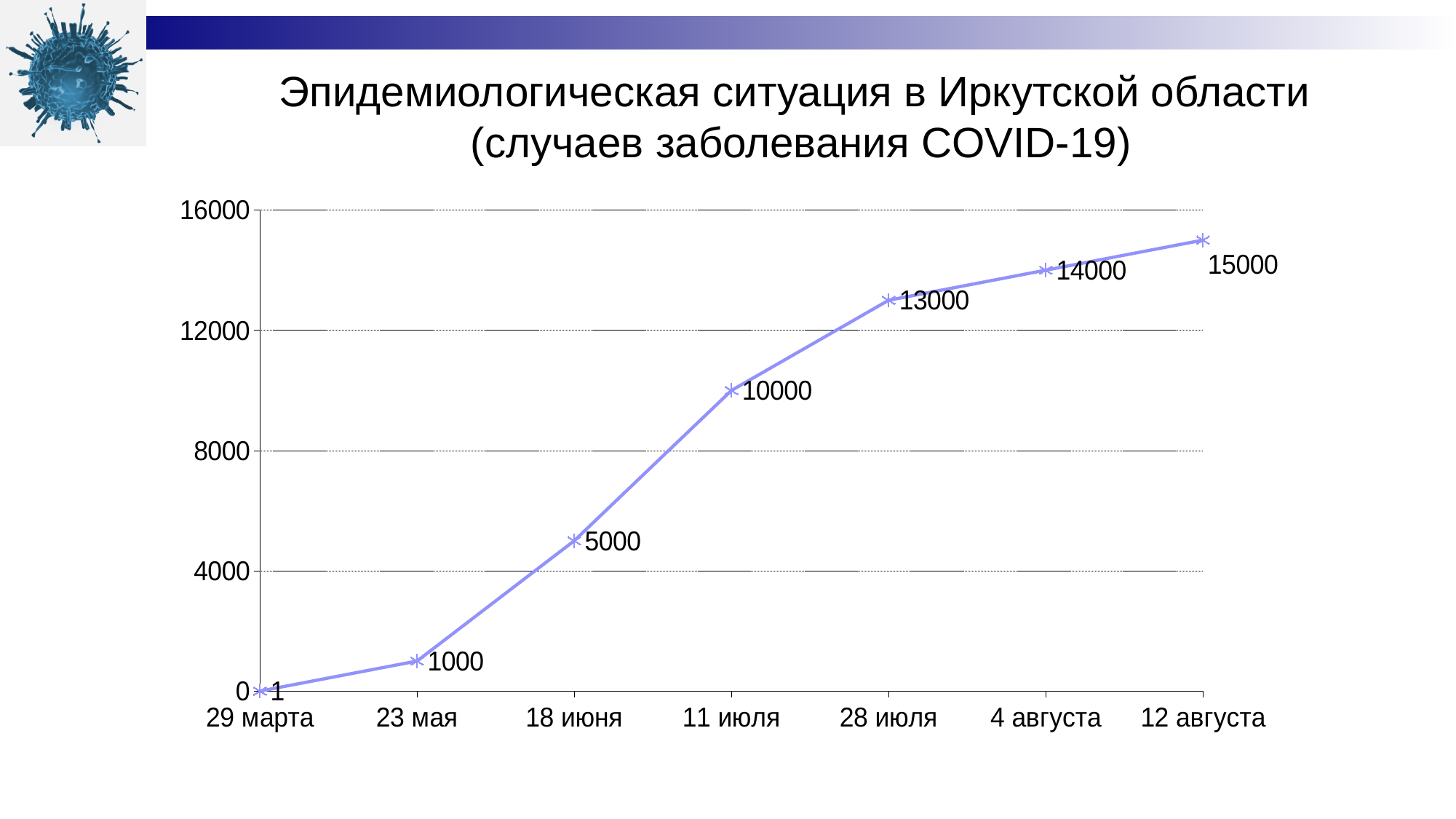
What is the difference between the values for 12 августа and 4 августа? 1000 What kind of chart is shown on the slide? line chart Which date has the highest value? 12 августа Which is larger, the value for 23 мая or the value for 18 июня? 18 июня What is the difference between the values for 11 июля and 18 июня? 5000 How many data points are plotted on the chart? 7 Which date has the lowest value? 29 марта What is the value for 28 июля? 13000 What is the value for 29 марта? 1 Do the values rise or fall from 29 марта to 12 августа? rise Is the value for 28 июля greater or less than 12000? greater What is the value for 18 июня? 5000